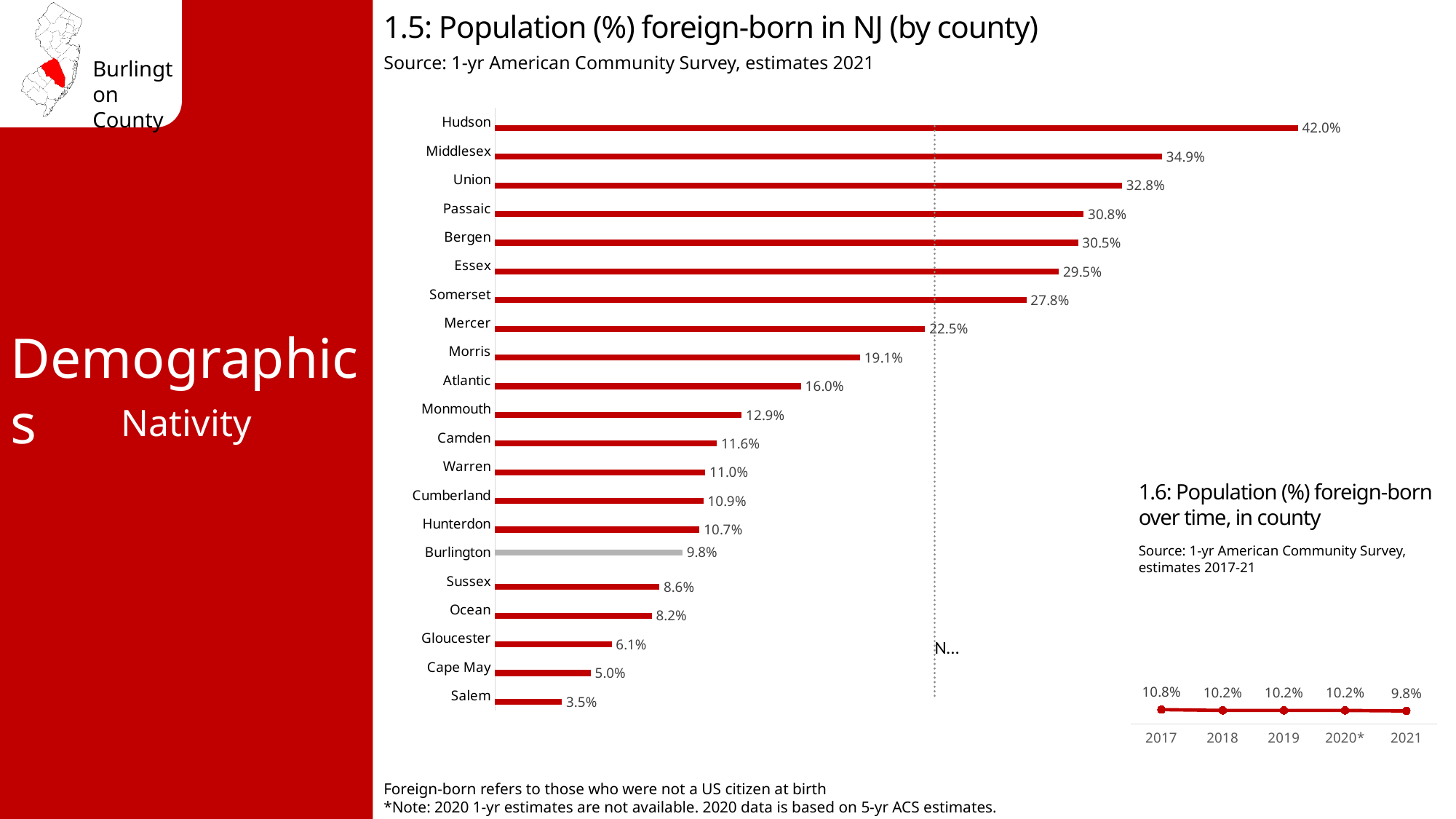
In chart 1.5 (Population (%) foreign-born in NJ by county), which county's bar is coloured grey instead of red? Burlington In chart 1.5 (Population (%) foreign-born in NJ by county), which is larger, Camden or Warren? Camden In chart 1.5 (Population (%) foreign-born in NJ by county), what is the value for Hudson? 42.0% In chart 1.5 (Population (%) foreign-born in NJ by county), which county has the highest value? Hudson In chart 1.5 (Population (%) foreign-born in NJ by county), which county has the lowest value? Salem In chart 1.6 (Population (%) foreign-born over time, in county), what is the value for 2017? 10.8% In chart 1.5 (Population (%) foreign-born in NJ by county), what is the value for Burlington? 9.8% In chart 1.5 (Population (%) foreign-born in NJ by county), how many counties are shown? 21 What kind of chart is chart 1.5 (Population (%) foreign-born in NJ by county)? bar chart In chart 1.6 (Population (%) foreign-born over time, in county), what is the value for 2021? 9.8% In chart 1.5 (Population (%) foreign-born in NJ by county), what is the difference between Middlesex and Union? 2.1% In chart 1.6 (Population (%) foreign-born over time, in county), do the values rise or fall from 2017 to 2021? fall